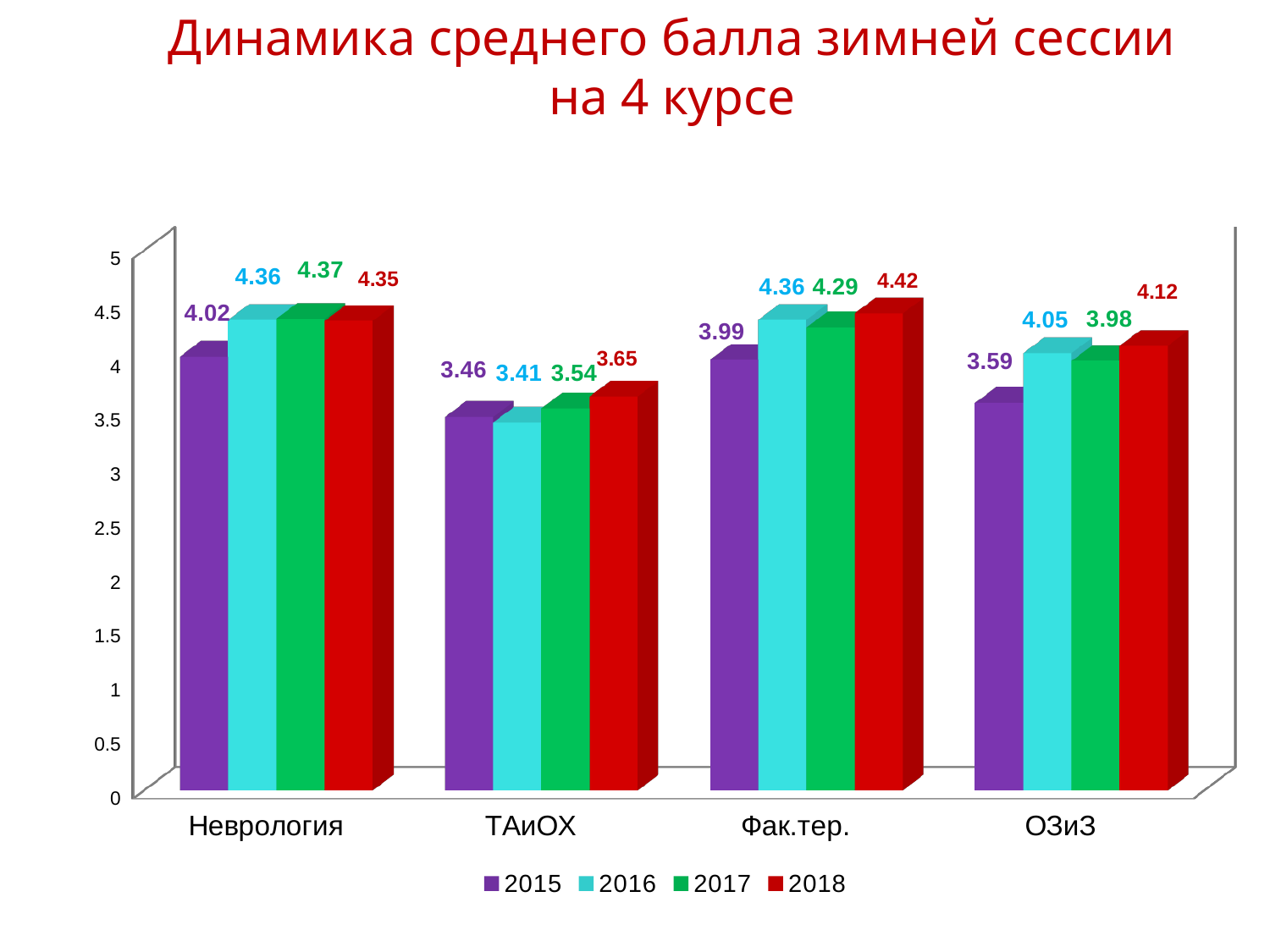
Which category has the lowest value in 2016? ТАиОХ How many categories are shown on the x axis? 4 Which colour represents the 2018 series in the legend? red What kind of chart is shown on the slide? bar chart Which category has the highest value in 2018? Фак.тер. What is the value for Неврология in 2015? 4.02 Is the value for ТАиОХ in 2016 greater or less than 3.5? less What is the difference between the 2018 and 2015 values for ОЗиЗ? 0.53 What is the value for ОЗиЗ in 2016? 4.05 What is the value for ТАиОХ in 2018? 3.65 How many series does the legend list? 4 Which is larger for Фак.тер.: the 2016 value or the 2017 value? 2016